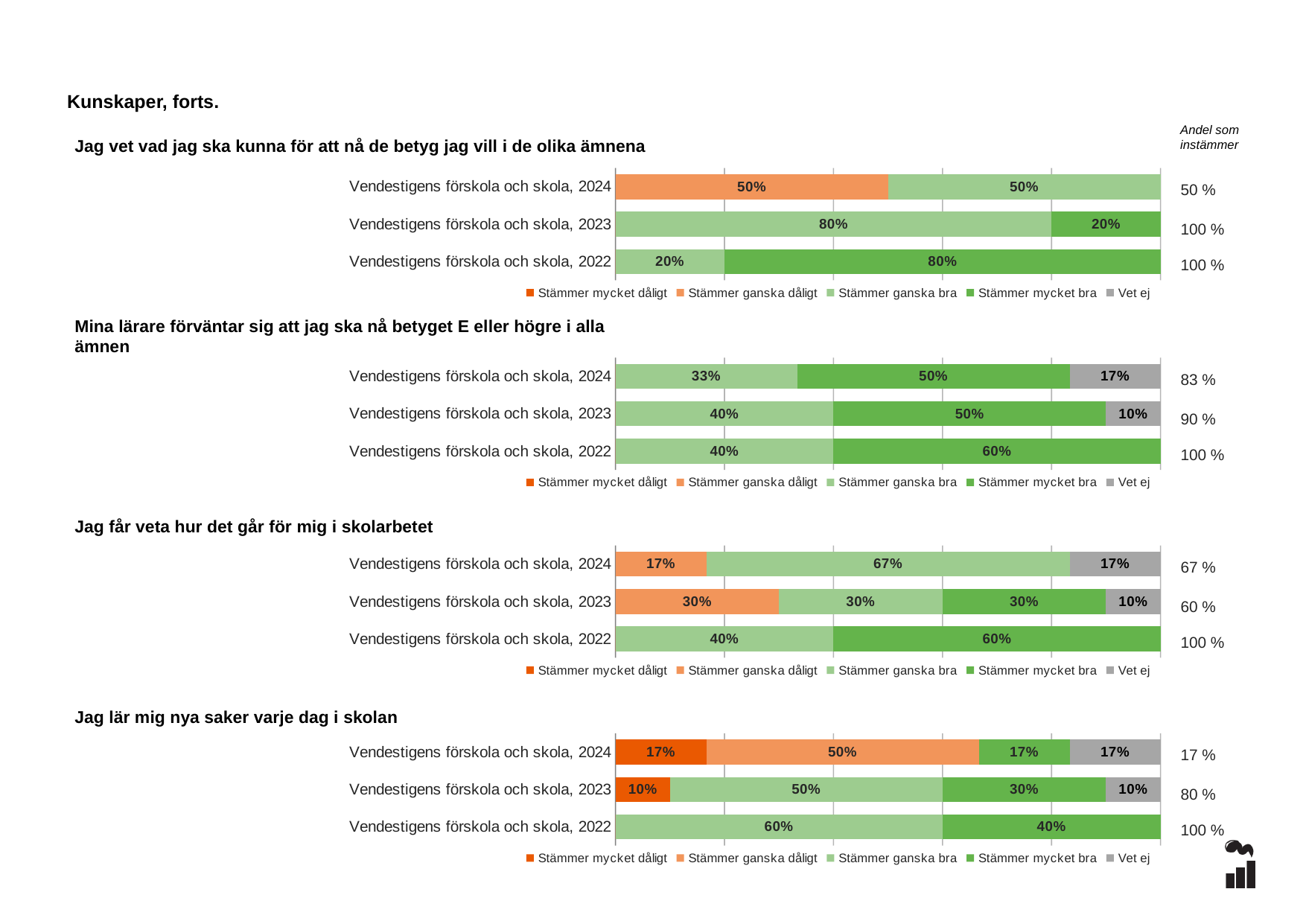
In the chart 'Jag lär mig nya saker varje dag i skolan', what is the 'Stämmer mycket dåligt' value for Vendestigens förskola och skola, 2023? 10% In the chart 'Jag får veta hur det går för mig i skolarbetet', what is the difference between the 'Stämmer ganska dåligt' values for 2023 and 2024? 13% In the chart 'Jag lär mig nya saker varje dag i skolan', what is the total of the 'Stämmer ganska bra' and 'Stämmer mycket bra' segments for 2022? 100% In the chart 'Jag vet vad jag ska kunna för att nå de betyg jag vill i de olika ämnena', what is the 'Stämmer ganska dåligt' value for Vendestigens förskola och skola, 2024? 50% What kind of chart is 'Jag lär mig nya saker varje dag i skolan'? Stacked bar chart In the chart 'Jag vet vad jag ska kunna för att nå de betyg jag vill i de olika ämnena', what is the 'Stämmer mycket bra' value for Vendestigens förskola och skola, 2022? 80% In the chart 'Jag får veta hur det går för mig i skolarbetet', what is the 'Stämmer ganska bra' value for Vendestigens förskola och skola, 2024? 67% How many series does the legend list for the chart 'Jag vet vad jag ska kunna för att nå de betyg jag vill i de olika ämnena'? 5 In the chart 'Mina lärare förväntar sig att jag ska nå betyget E eller högre i alla ämnen', which year has the highest 'Stämmer mycket bra' value? 2022 In the chart 'Jag lär mig nya saker varje dag i skolan', which is larger: the 'Stämmer mycket bra' value for 2023 or for 2024? 2023 How many bars are shown in the chart 'Jag får veta hur det går för mig i skolarbetet'? 3 In the chart 'Mina lärare förväntar sig att jag ska nå betyget E eller högre i alla ämnen', what is the 'Vet ej' value for Vendestigens förskola och skola, 2024? 17%